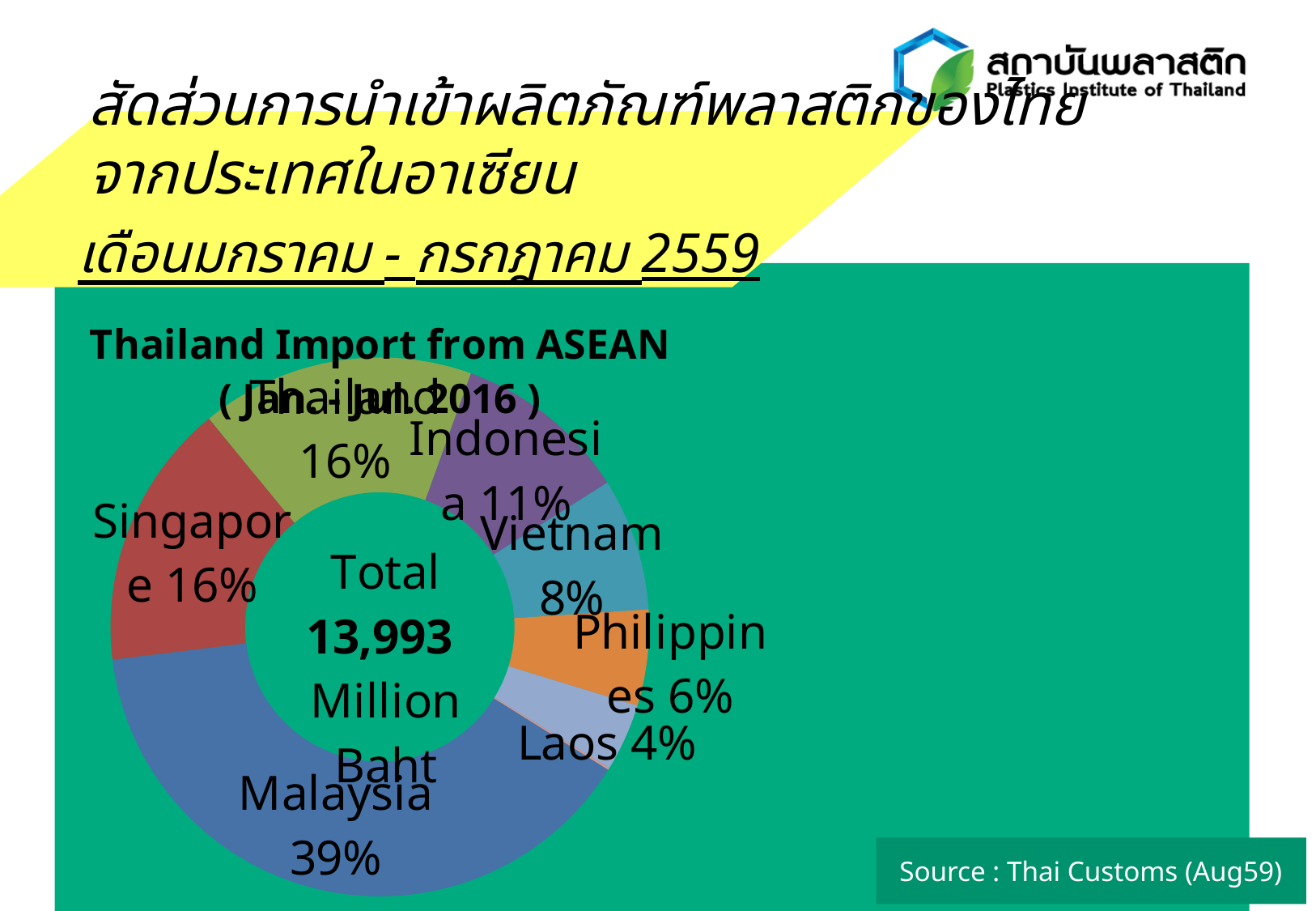
What percentage is shown for Laos? 4% What share of Thailand's imports from ASEAN comes from Malaysia? 39% What percentage is shown for Singapore? 16% What percentage is shown for Vietnam? 8% Which country has the largest share of Thailand's imports from ASEAN? Malaysia How many percentage points larger is Malaysia's share than Singapore's? 23% What percentage is shown for the Philippines? 6% What percentage is shown for Indonesia? 11% What kind of chart is shown on the slide? Doughnut (pie) chart Which labelled country has the smallest share in the chart? Laos Which has a larger share, Indonesia or Vietnam? Indonesia What total value is shown in the centre of the chart? 13,993 Million Baht